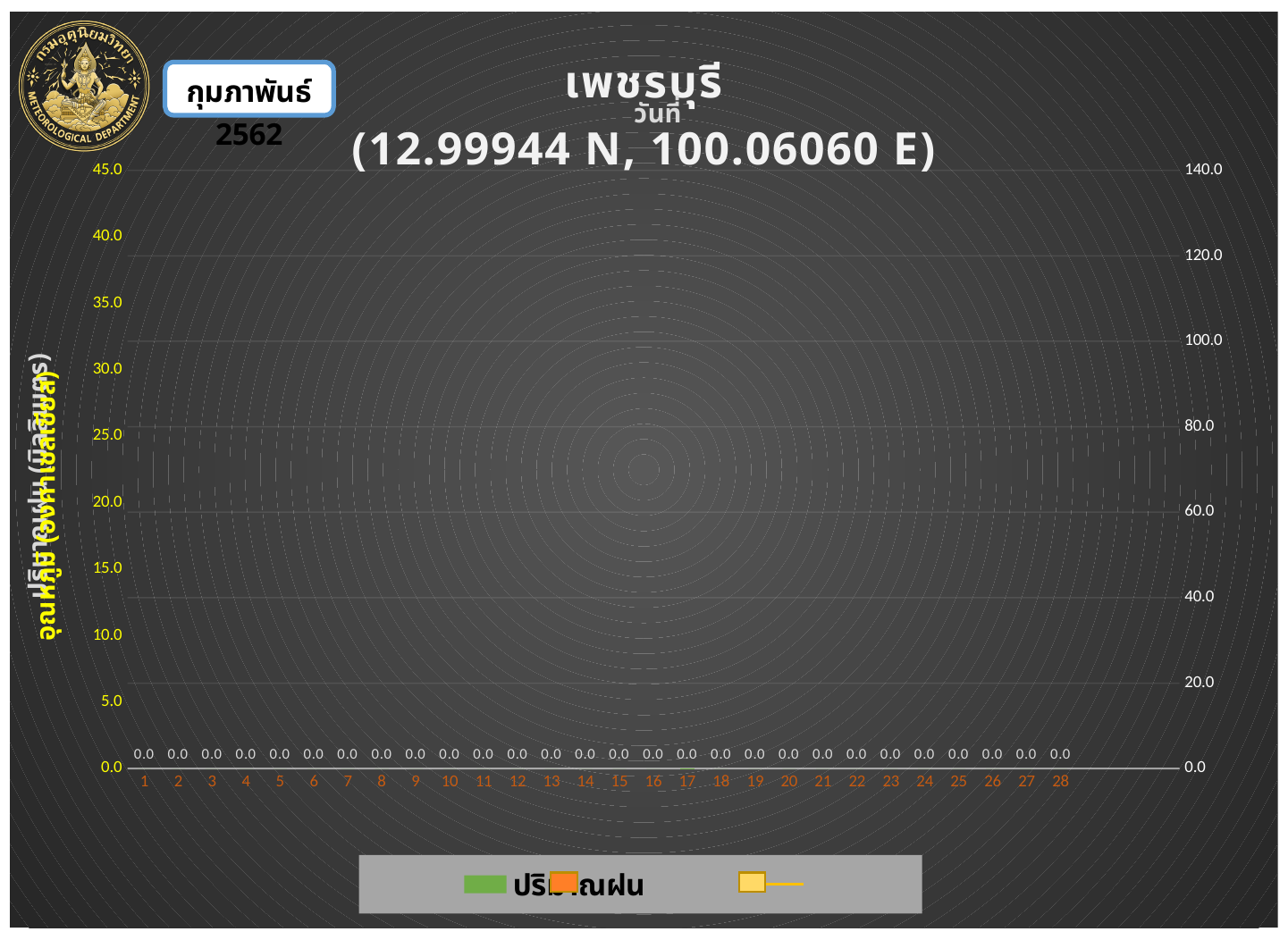
Is the value for day 10 greater or less than 5.0 on the left axis? less What is the highest tick value on the right vertical axis? 140.0 What is the rainfall value shown for day 1? 0.0 How many days (categories) are shown along the x axis? 28 What is the total of the labelled values for days 1 through 28? 0.0 Do the labelled values rise, fall, or stay the same from day 1 to day 28? stay the same What is the difference between the values for day 5 and day 20? 0.0 What coordinates are given in the chart title? 12.99944 N, 100.06060 E What is the value labelled above day 15 on the x axis? 0.0 What is the value labelled above day 28? 0.0 What is the highest tick value on the left vertical axis? 45.0